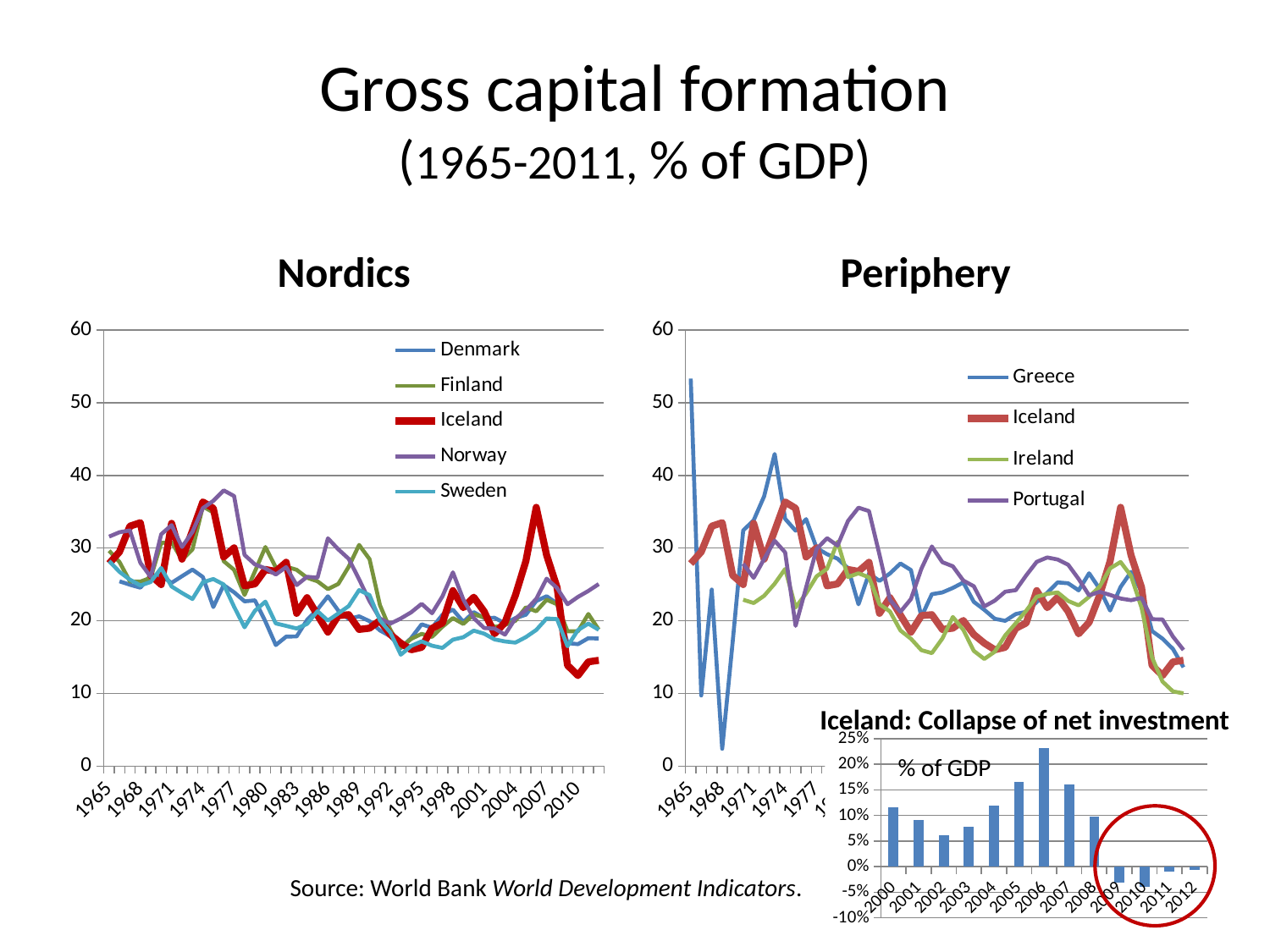
In the Nordics chart, does the Sweden line overall rise or fall from 1965 to 2011? fall In the 'Iceland: Collapse of net investment' chart, is the value for 2006 greater or less than 20%? greater How many series does the legend of the Periphery chart list? 4 What kind of chart is the Nordics chart? line chart In the 'Iceland: Collapse of net investment' chart, which year has the highest value? 2006 What kind of chart is the 'Iceland: Collapse of net investment' chart? bar chart How many series does the legend of the Nordics chart list? 5 In the 'Iceland: Collapse of net investment' chart, is the value for 2002 greater or less than 10%? less In the Nordics chart, which series is drawn with the thick red line? Iceland How many years (bars) are shown in the 'Iceland: Collapse of net investment' chart? 13 In the Periphery chart, is the value for Greece in 1965 greater or less than 50? greater In the 'Iceland: Collapse of net investment' chart, which year has the larger value, 2005 or 2006? 2006